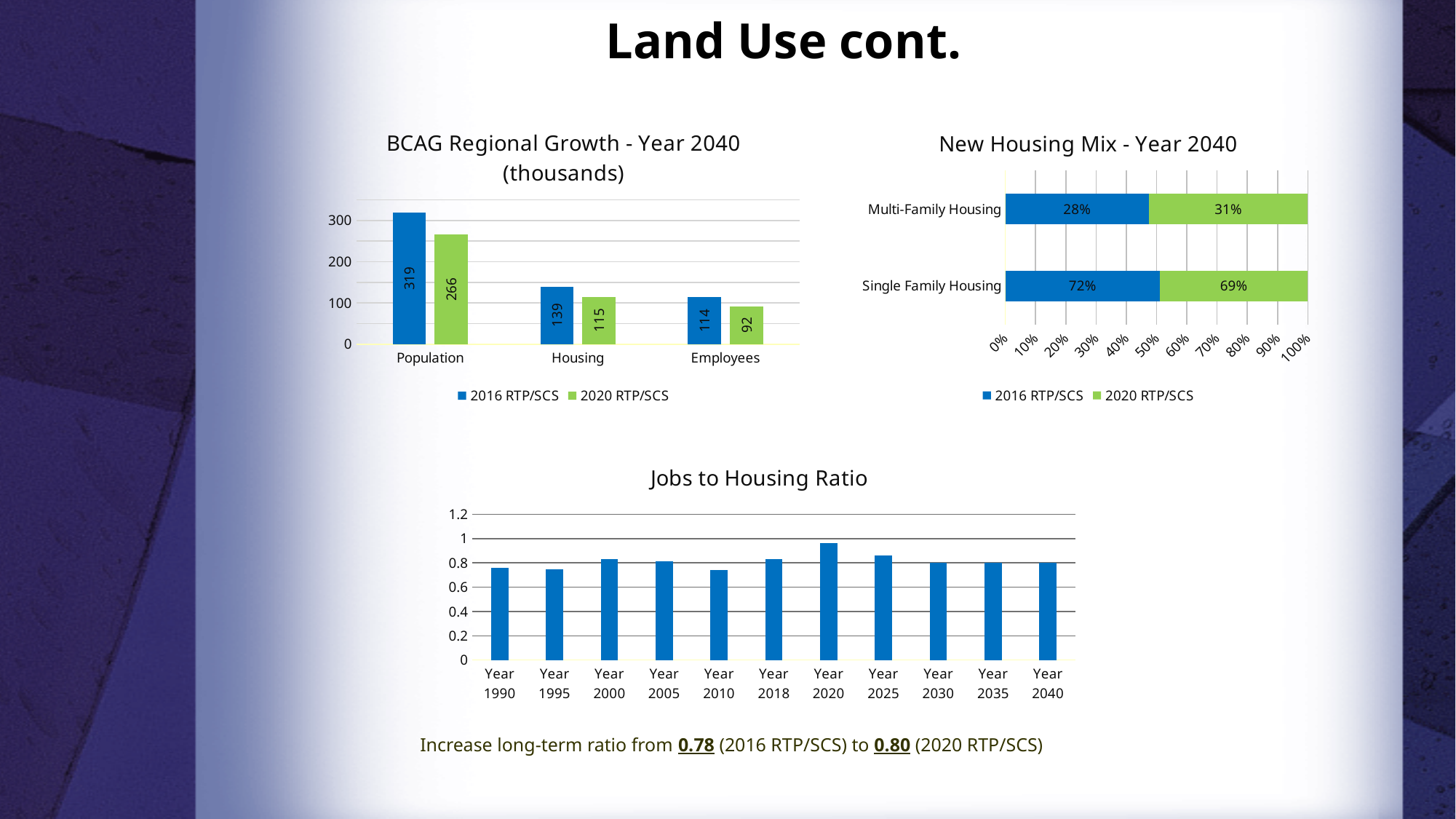
In the New Housing Mix - Year 2040 chart, what is the 2020 RTP/SCS share for Multi-Family Housing? 31% In the New Housing Mix - Year 2040 chart, what is the 2016 RTP/SCS share for Single Family Housing? 72% In the BCAG Regional Growth - Year 2040 chart, how many categories are shown on the x axis? 3 In the Jobs to Housing Ratio chart, which year has the highest ratio? Year 2020 In the BCAG Regional Growth - Year 2040 chart, what is the 2016 RTP/SCS value for Population? 319 How many series does the legend of the New Housing Mix - Year 2040 chart list? 2 What kind of chart is the Jobs to Housing Ratio chart? Bar chart In the BCAG Regional Growth - Year 2040 chart, what is the difference between the 2016 RTP/SCS and 2020 RTP/SCS values for Housing? 24 In the New Housing Mix - Year 2040 chart, which is larger for Single Family Housing: the 2016 RTP/SCS value or the 2020 RTP/SCS value? 2016 RTP/SCS In the Jobs to Housing Ratio chart, is the value for Year 2010 greater or less than 0.8? less In the BCAG Regional Growth - Year 2040 chart, which category has the highest 2016 RTP/SCS value? Population In the BCAG Regional Growth - Year 2040 chart, what is the 2020 RTP/SCS value for Employees? 92